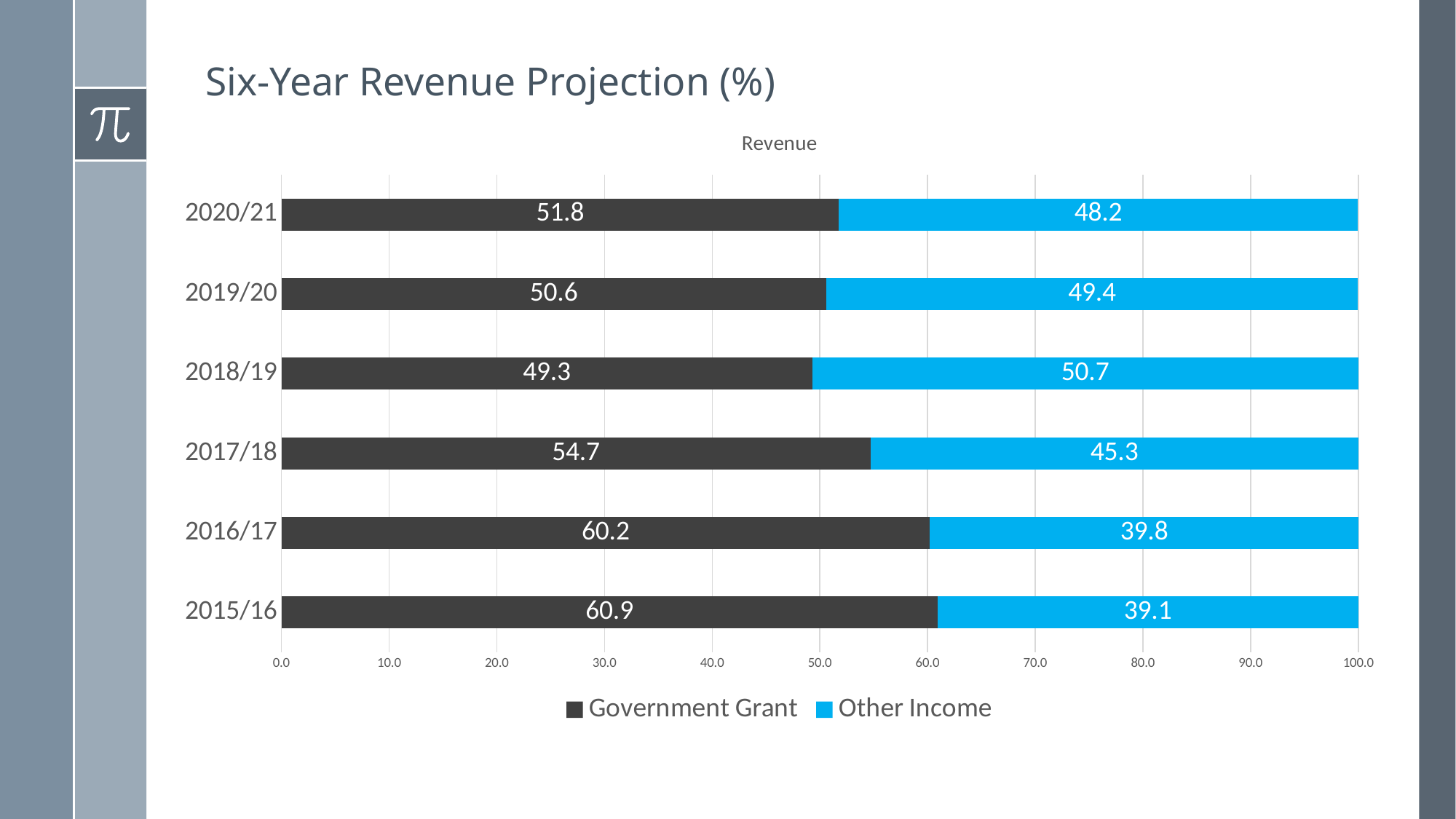
How many series does the legend list? 2 What is the title of the chart? Revenue Which year has the lowest Other Income value? 2015/16 How many years are shown on the chart? 6 Which is larger for 2017/18: Government Grant or Other Income? Government Grant What kind of chart is shown on the slide? Stacked bar chart What is the Government Grant value for 2020/21? 51.8 What is the Other Income value for 2016/17? 39.8 What is the difference between the Government Grant values for 2015/16 and 2020/21? 9.1 What is the Other Income value for 2018/19? 50.7 Which year has the highest Government Grant value? 2015/16 What is the total of the stacked bar for 2019/20? 100.0